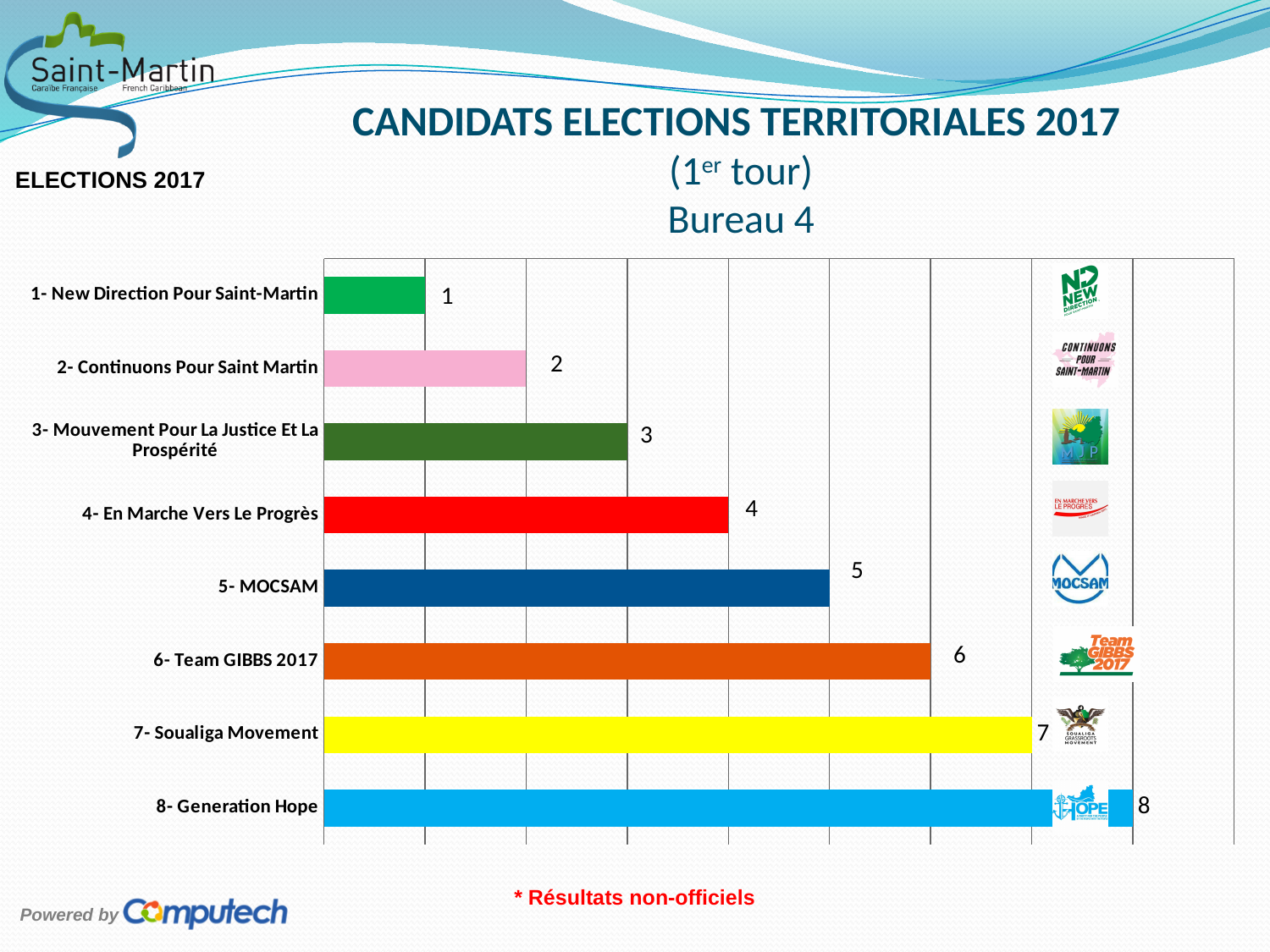
What colour is the bar for 4- En Marche Vers Le Progrès? red What kind of chart is shown on the slide? bar chart Which category has the lowest value in the chart? 1- New Direction Pour Saint-Martin What is the title of the chart? CANDIDATS ELECTIONS TERRITORIALES 2017 (1er tour) Bureau 4 What is the value shown for 5- MOCSAM? 5 What is the value shown for 7- Soualiga Movement? 7 Which has the larger value, 4- En Marche Vers Le Progrès or 2- Continuons Pour Saint Martin? 4- En Marche Vers Le Progrès Which category has the highest value in the chart? 8- Generation Hope Do the bar values increase or decrease going down the chart from the top category to the bottom category? increase What is the difference between the values for 6- Team GIBBS 2017 and 3- Mouvement Pour La Justice Et La Prospérité? 3 What is the value shown for 2- Continuons Pour Saint Martin? 2 How many candidate lists (categories) are plotted in the chart? 8